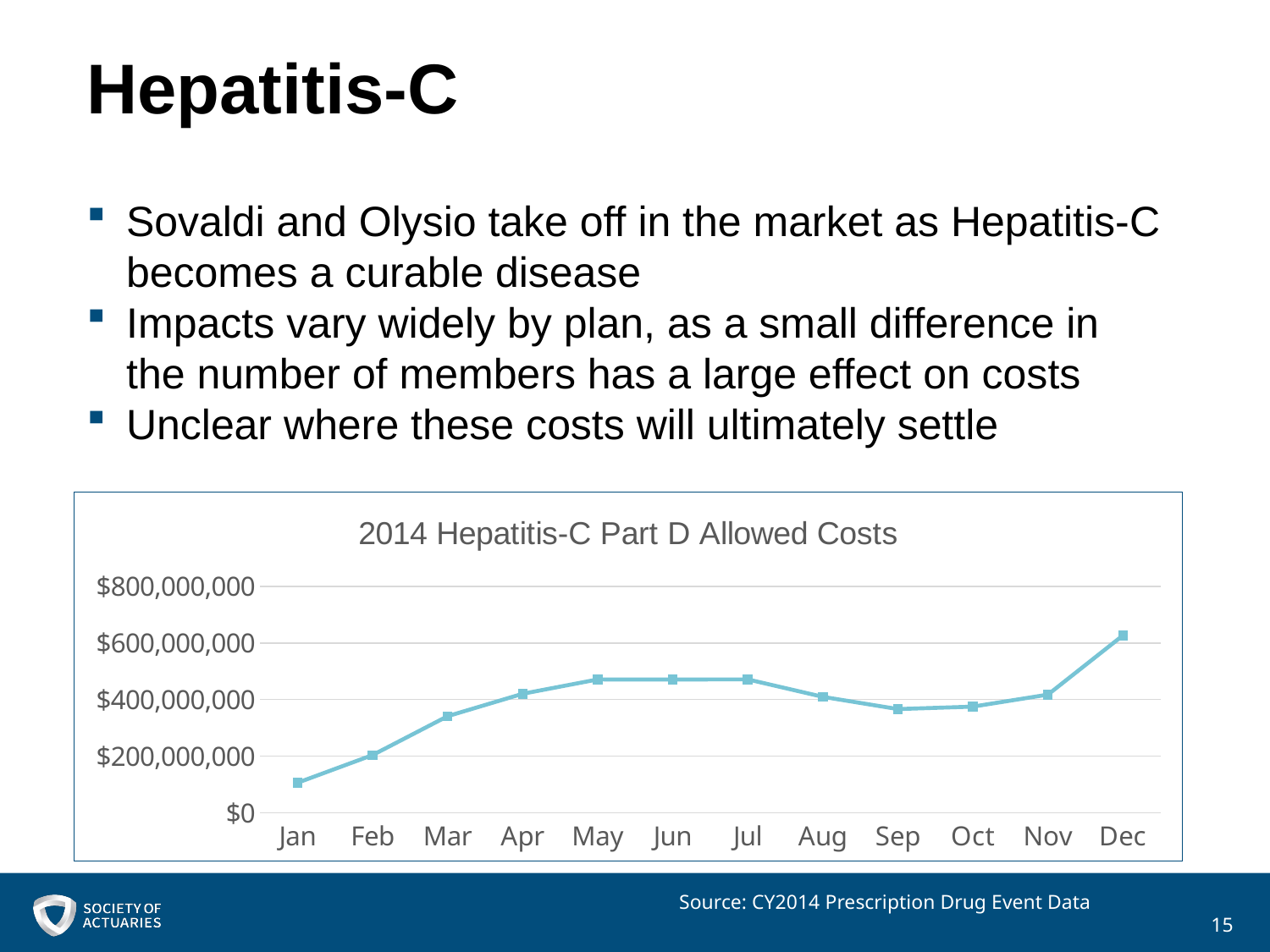
Which month has the larger allowed cost, Dec or Jul? Dec Which month has the lowest allowed cost in the chart? Jan What kind of chart is shown on the slide? line chart Do the allowed costs rise or fall from Jan to May? rise Which month has the highest allowed cost in the chart? Dec How many months are plotted on the x axis of the chart? 12 Which month has the larger allowed cost, Mar or Sep? Sep Is the value for May greater or less than $400,000,000? greater Is the value for Dec greater or less than $600,000,000? greater Is the value for Sep greater or less than $400,000,000? less What is the title of the chart? 2014 Hepatitis-C Part D Allowed Costs